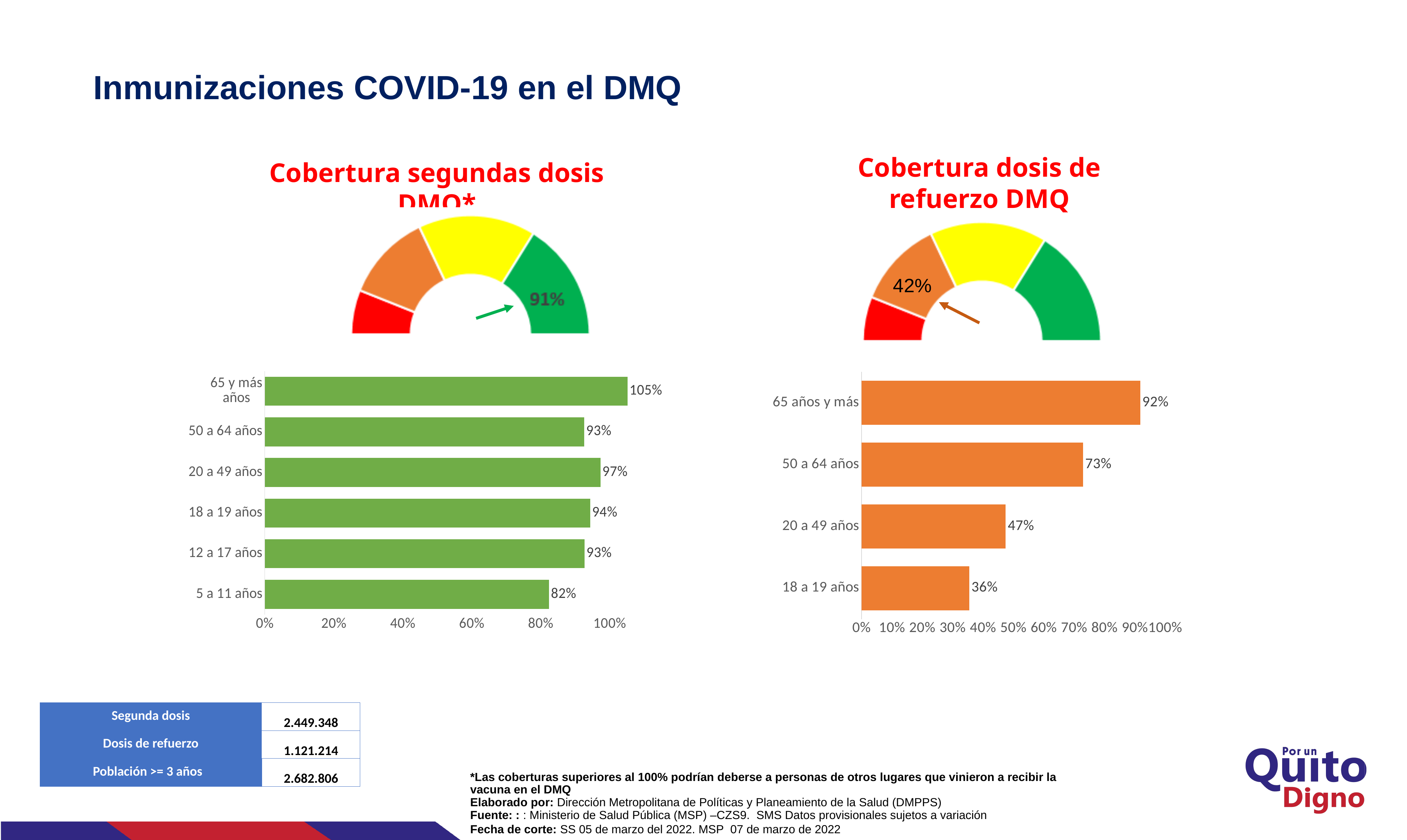
In the 'Cobertura segundas dosis DMQ' bar chart, how many age groups are shown? 6 In the 'Cobertura dosis de refuerzo DMQ' bar chart, what is the value for 50 a 64 años? 73% In the 'Cobertura segundas dosis DMQ' bar chart, which age group has the lowest value? 5 a 11 años What value does the gauge under 'Cobertura dosis de refuerzo DMQ' show? 42% In the 'Cobertura dosis de refuerzo DMQ' bar chart, what is the difference between 65 años y más and 18 a 19 años? 56% In the 'Cobertura dosis de refuerzo DMQ' bar chart, which age group has the highest value? 65 años y más In the 'Cobertura segundas dosis DMQ' bar chart, what is the difference between 20 a 49 años and 5 a 11 años? 15% What type of chart is used below the gauge in 'Cobertura dosis de refuerzo DMQ'? Bar chart What value does the gauge under 'Cobertura segundas dosis DMQ' show? 91% In the 'Cobertura dosis de refuerzo DMQ' bar chart, which is larger: 20 a 49 años or 18 a 19 años? 20 a 49 años In the 'Cobertura segundas dosis DMQ' bar chart, what is the value for 5 a 11 años? 82% In the 'Cobertura segundas dosis DMQ' bar chart, what is the value for 65 y más años? 105%